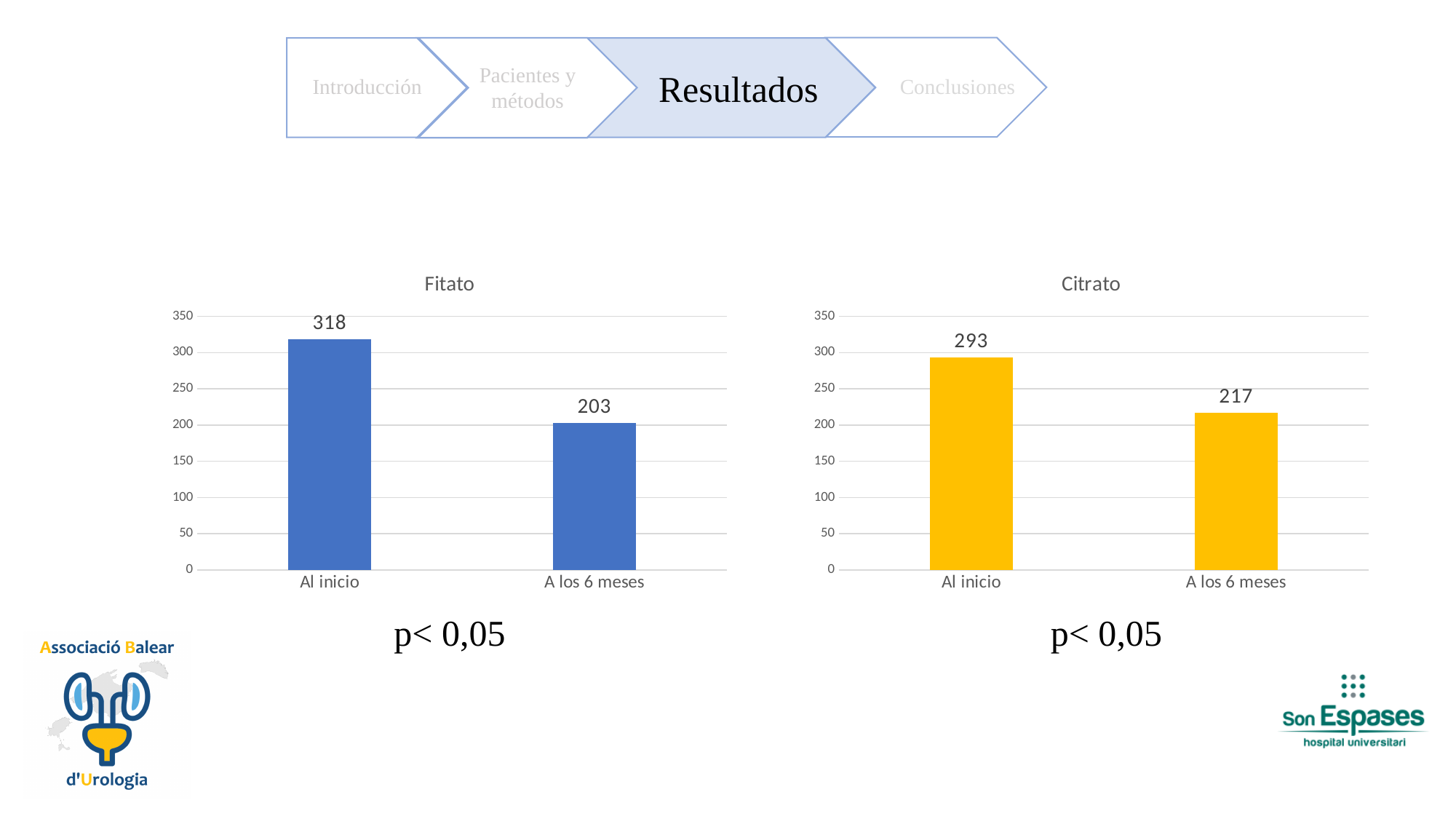
Comparing the Al inicio values, which chart shows the larger value, Fitato or Citrato? Fitato In the Fitato chart, what is the value for A los 6 meses? 203 In the Fitato chart, what is the value for Al inicio? 318 In the Fitato chart, which category has the highest value? Al inicio In the Citrato chart, what is the difference between the Al inicio and A los 6 meses values? 76 In the Citrato chart, what is the value for Al inicio? 293 In the Citrato chart, which category has the lowest value? A los 6 meses In the Citrato chart, do the values rise or fall from Al inicio to A los 6 meses? fall What kind of chart is the Citrato chart? bar chart In the Citrato chart, what is the value for A los 6 meses? 217 In the Fitato chart, what is the difference between the Al inicio and A los 6 meses values? 115 How many categories are shown in the Fitato chart? 2